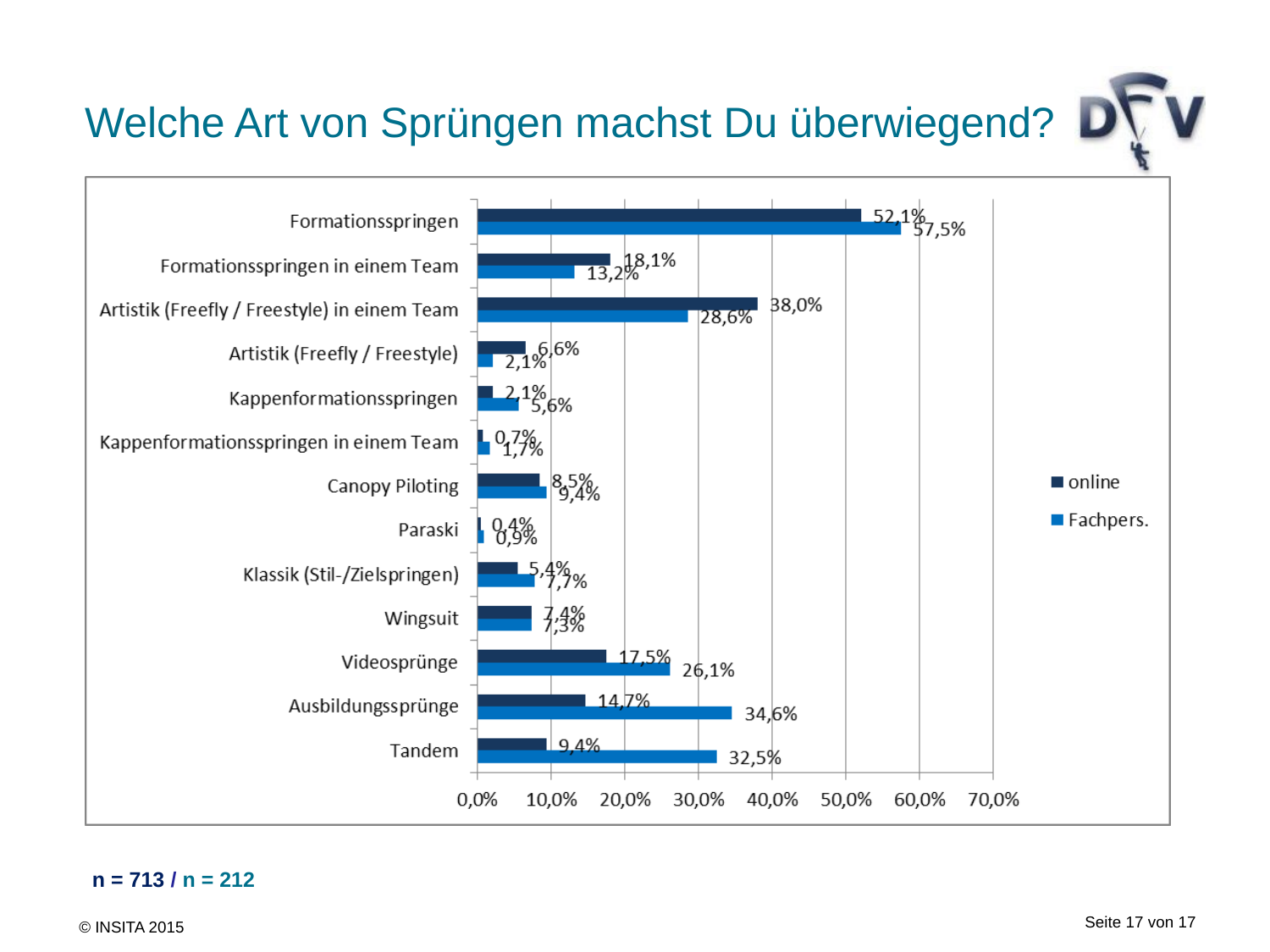
What kind of chart is shown on the slide? bar chart What is the online value for Artistik (Freefly / Freestyle) in einem Team? 38,0% What is the difference between the Fachpers. and online values for Tandem? 23,1 percentage points For Videosprünge, which series has the larger value, online or Fachpers.? Fachpers. Which category has the highest Fachpers. value? Formationsspringen How many series does the legend list? 2 How many categories of jump types are shown on the chart? 13 What is the online value for Tandem? 9,4% Which category has the lowest online value? Paraski Is the online value for Formationsspringen greater or less than 50,0%? greater What is the Fachpers. value for Formationsspringen? 57,5% What is the Fachpers. value for Ausbildungssprünge? 34,6%